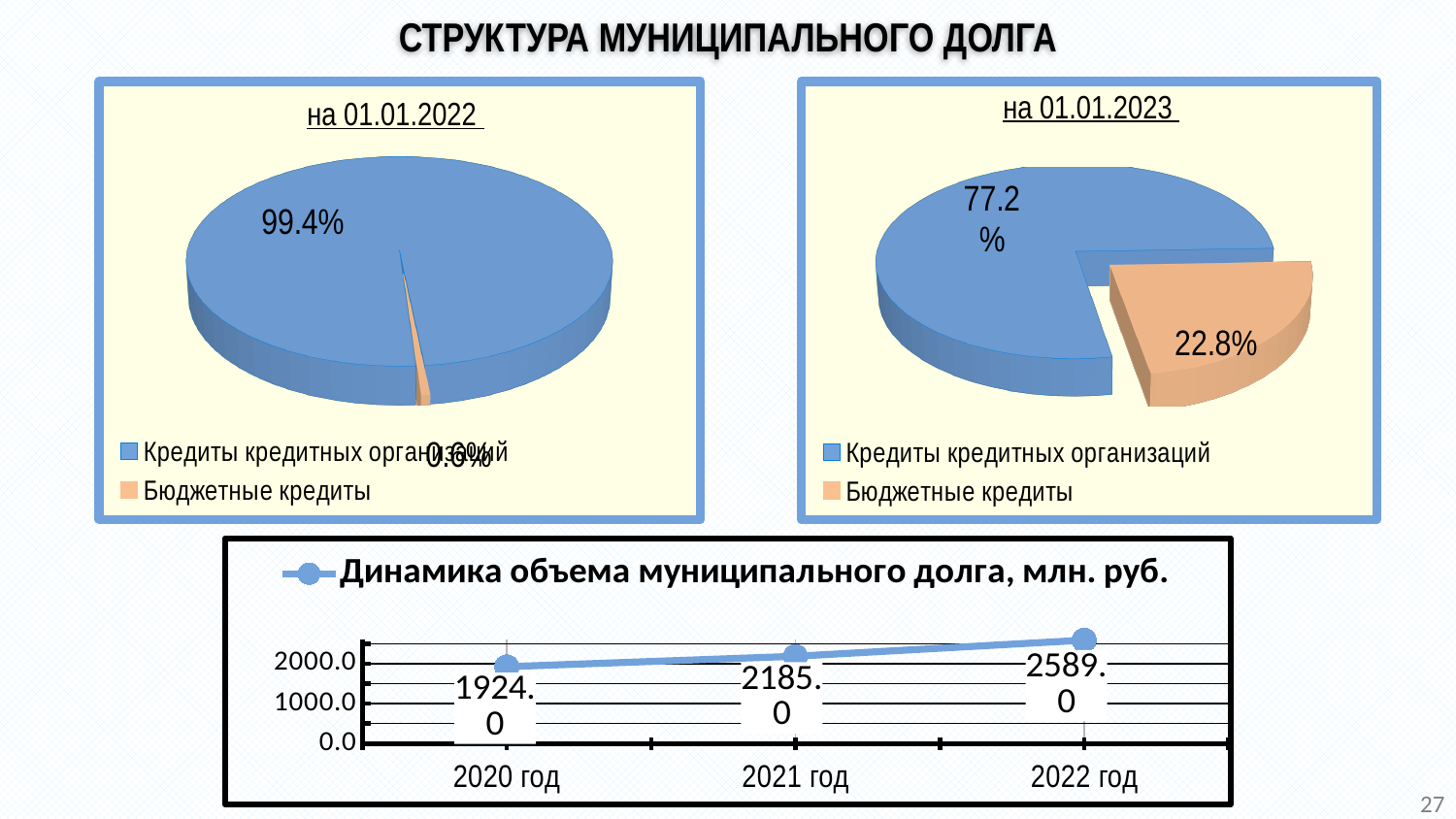
In the line chart 'Динамика объема муниципального долга, млн. руб.', do the values rise or fall from 2020 год to 2022 год? rise In the pie chart 'на 01.01.2022', which category has the smallest slice? Бюджетные кредиты In the line chart 'Динамика объема муниципального долга, млн. руб.', what is the value for 2020 год? 1924.0 In the pie chart 'на 01.01.2022', what share is shown for Кредиты кредитных организаций? 99.4% How many categories does the legend of the pie chart 'на 01.01.2023' list? 2 In the pie chart 'на 01.01.2023', what share is shown for Бюджетные кредиты? 22.8% In the line chart 'Динамика объема муниципального долга, млн. руб.', what is the value for 2022 год? 2589.0 In the pie chart 'на 01.01.2023', which category has the largest slice? Кредиты кредитных организаций In the line chart 'Динамика объема муниципального долга, млн. руб.', what is the difference between the values for 2022 год and 2021 год? 404.0 How many data points are plotted in the line chart 'Динамика объема муниципального долга, млн. руб.'? 3 In the pie chart 'на 01.01.2023', what share is shown for Кредиты кредитных организаций? 77.2% What kind of chart is the chart at the bottom of the slide? line chart